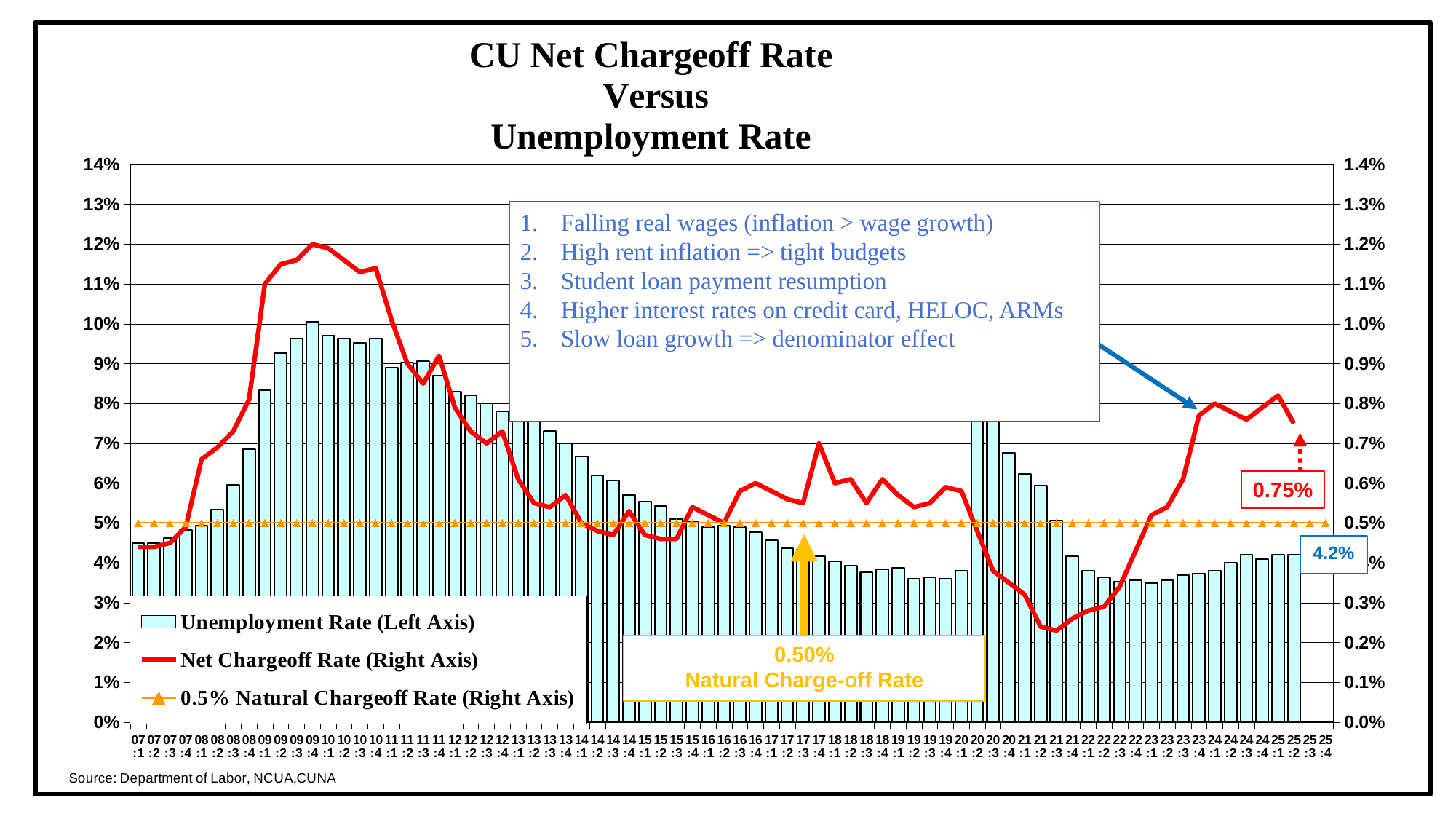
In which quarter does the Net Chargeoff Rate reach its highest point? 09:4 What value is given for the Natural Charge-off Rate? 0.50% Is the Net Chargeoff Rate in 21:3 greater or less than 0.3%? less How many series does the legend list? 3 What is the most recent Net Chargeoff Rate value labeled on the chart? 0.75% Does the Unemployment Rate generally rise or fall from 10:1 to 19:4? fall Which is larger, the Net Chargeoff Rate in 09:4 or in 23:4? 09:4 Is the Unemployment Rate in 10:1 greater or less than 9%? greater What kind of chart is used to plot the Unemployment Rate series? Bar chart What is the most recent Unemployment Rate value labeled on the chart? 4.2% What does the orange line with triangle markers represent? 0.5% Natural Chargeoff Rate (Right Axis) Is the Unemployment Rate in 07:1 greater or less than 5%? less